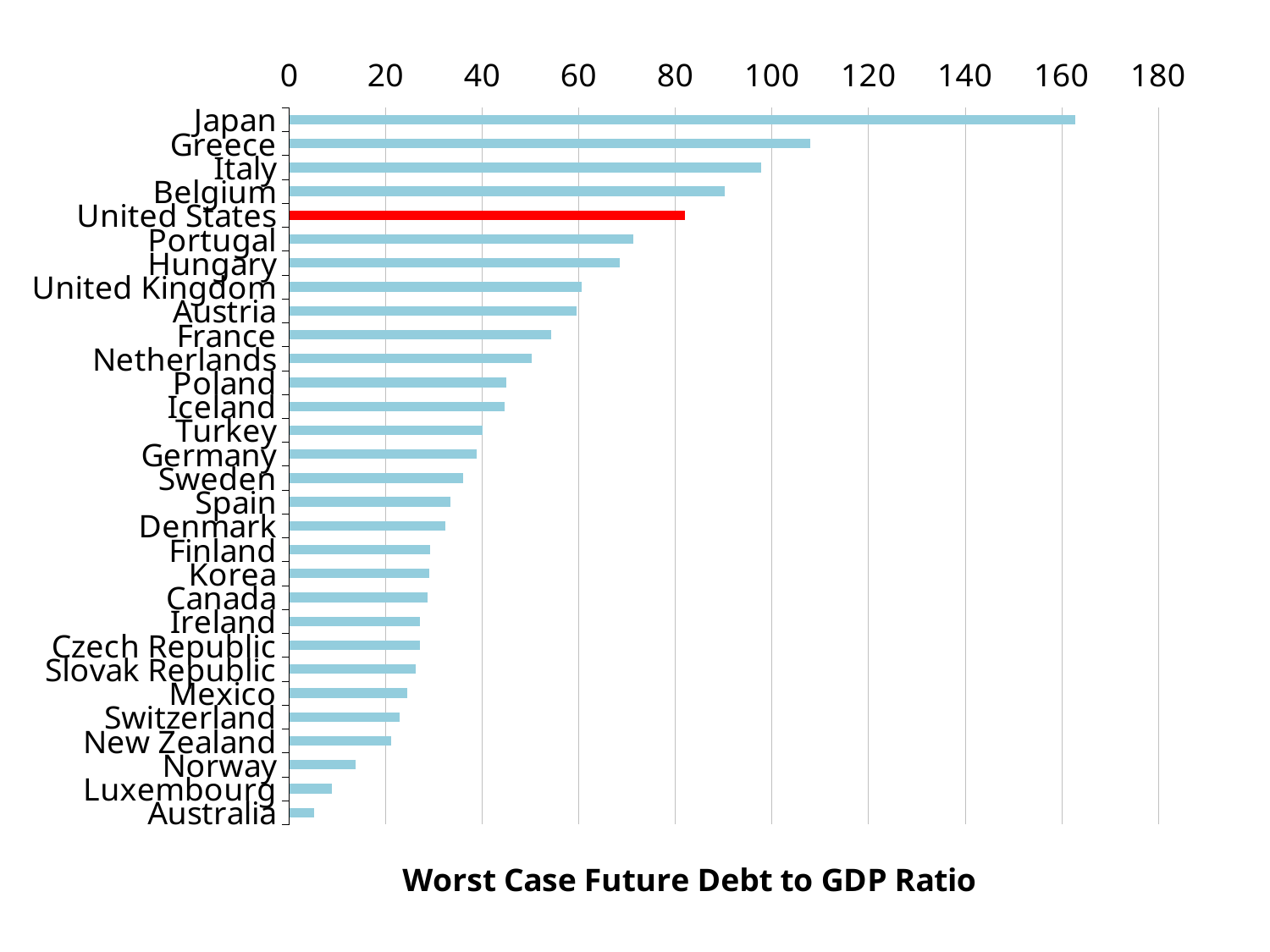
Is the value for Greece greater or less than 100? greater What kind of chart is shown on the slide? Bar chart Which country has the highest worst case future debt to GDP ratio? Japan Which country has the lowest worst case future debt to GDP ratio? Australia Which country's bar is highlighted in red? United States Is the value for Japan greater or less than 140? greater Is the value for the United States greater or less than 100? less Which has a higher worst case future debt to GDP ratio, Greece or Italy? Greece How many countries are shown in the chart? 30 What is the title of the chart? Worst Case Future Debt to GDP Ratio